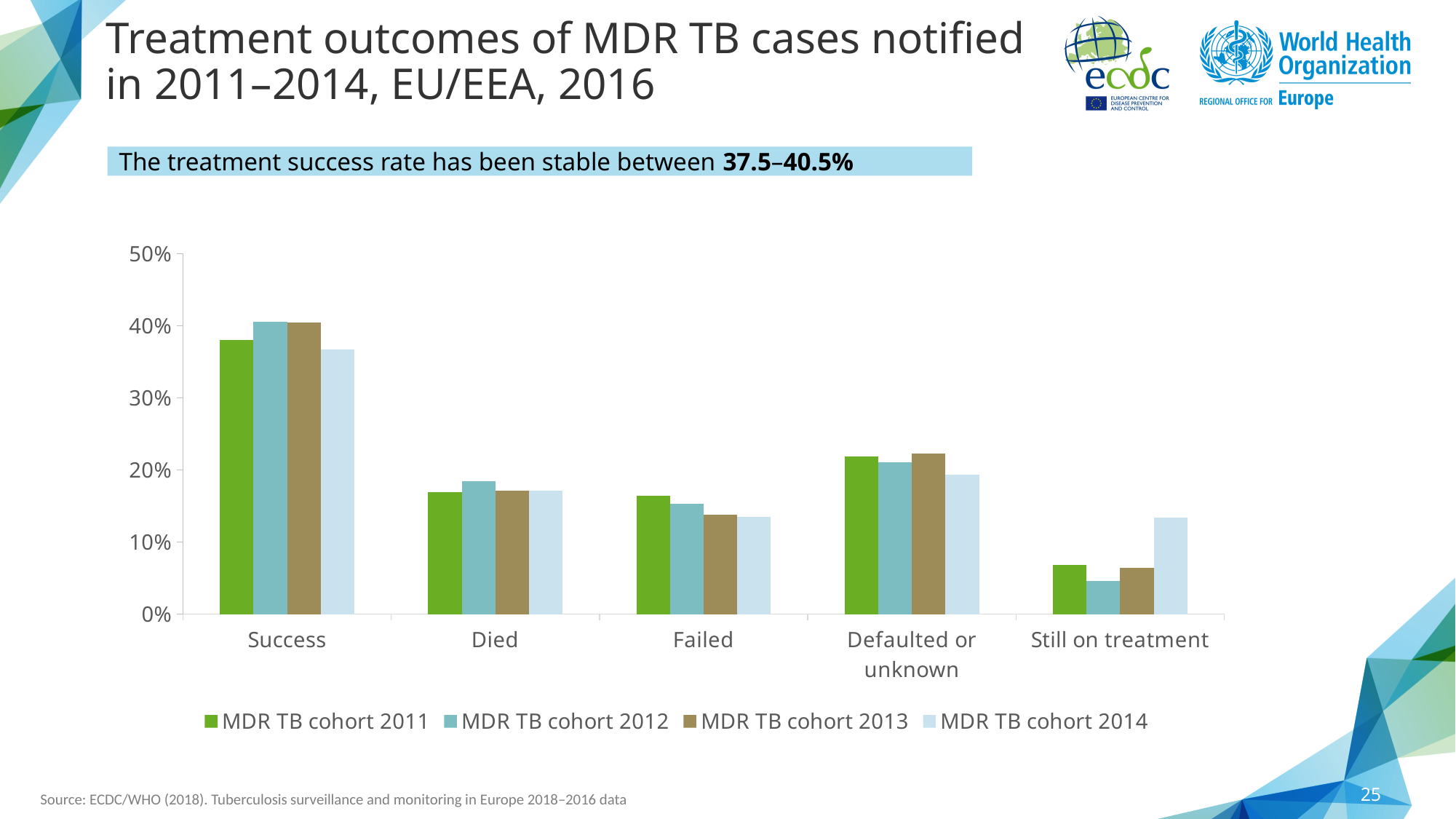
For Failed, which is larger: MDR TB cohort 2011 or MDR TB cohort 2014? MDR TB cohort 2011 Which outcome category has the highest value for MDR TB cohort 2011? Success Is the Still on treatment value for MDR TB cohort 2014 greater or less than 10%? greater How many outcome categories are shown on the x axis? 5 Is the Defaulted or unknown value for MDR TB cohort 2013 greater or less than 20%? greater Is the Success value for MDR TB cohort 2014 greater or less than 40%? less What is the highest tick value shown on the y axis? 50% For Still on treatment, which is larger: MDR TB cohort 2011 or MDR TB cohort 2014? MDR TB cohort 2014 Within the Still on treatment category, which cohort has the highest value? MDR TB cohort 2014 What kind of chart is shown on the slide? Bar chart How many series does the legend list? 4 Which outcome category has the lowest value for MDR TB cohort 2012? Still on treatment